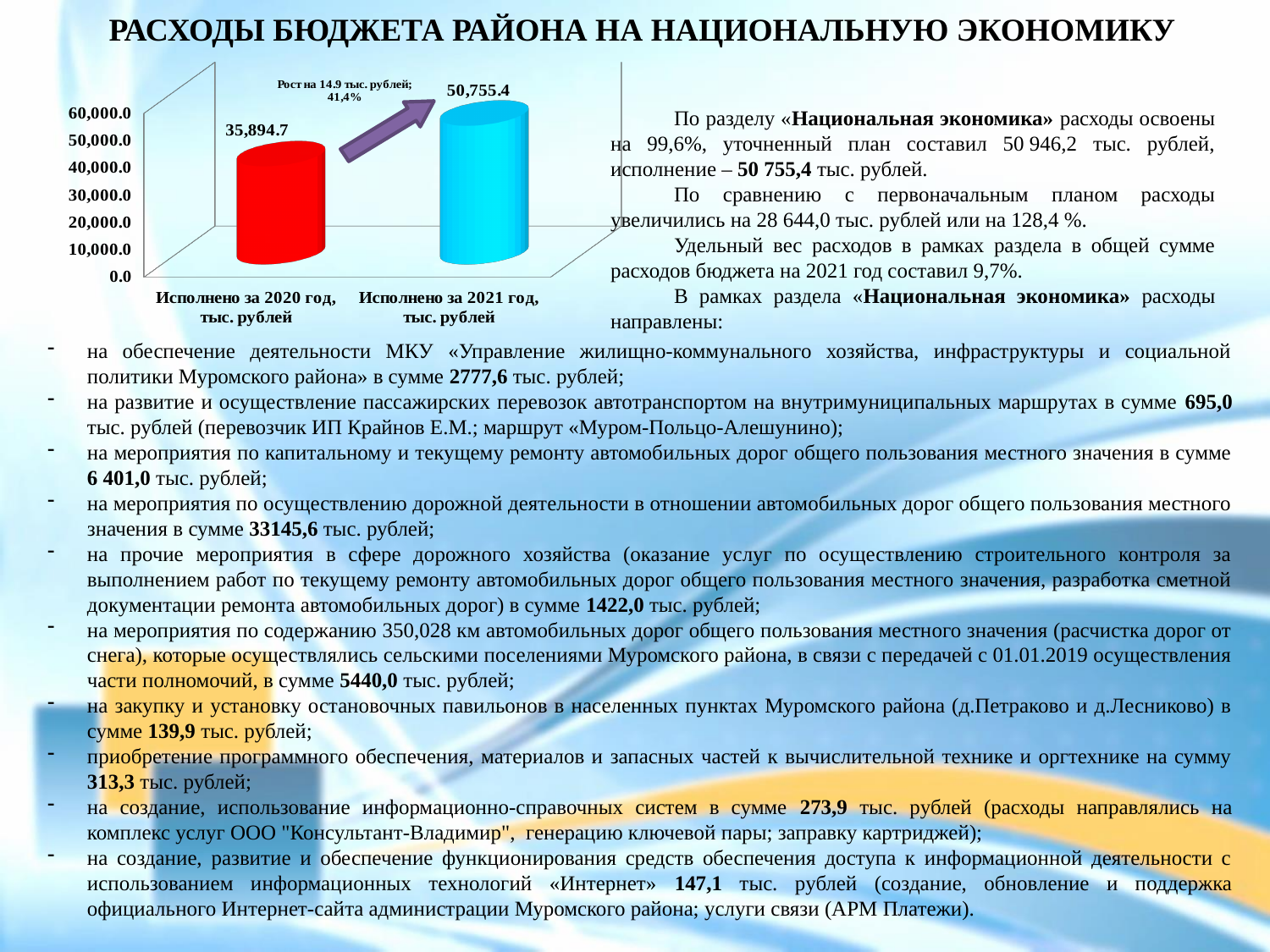
Which category has the highest value? Исполнено за 2021 год, тыс. рублей Do the values rise or fall from 2020 to 2021? rise How many categories are shown in the chart? 2 What is the difference between the 2021 value and the 2020 value? 14,860.7 Is the value for "Исполнено за 2020 год" greater or less than 40,000.0? less What is the value for "Исполнено за 2020 год, тыс. рублей"? 35,894.7 What kind of chart is shown on the slide? bar chart What growth percentage is stated in the annotation above the arrow in the chart? 41,4% Which is larger: the value for 2020 or the value for 2021? Исполнено за 2021 год, тыс. рублей Which category has the lowest value? Исполнено за 2020 год, тыс. рублей What is the value for "Исполнено за 2021 год, тыс. рублей"? 50,755.4 Is the value for "Исполнено за 2021 год" greater or less than 50,000.0? greater